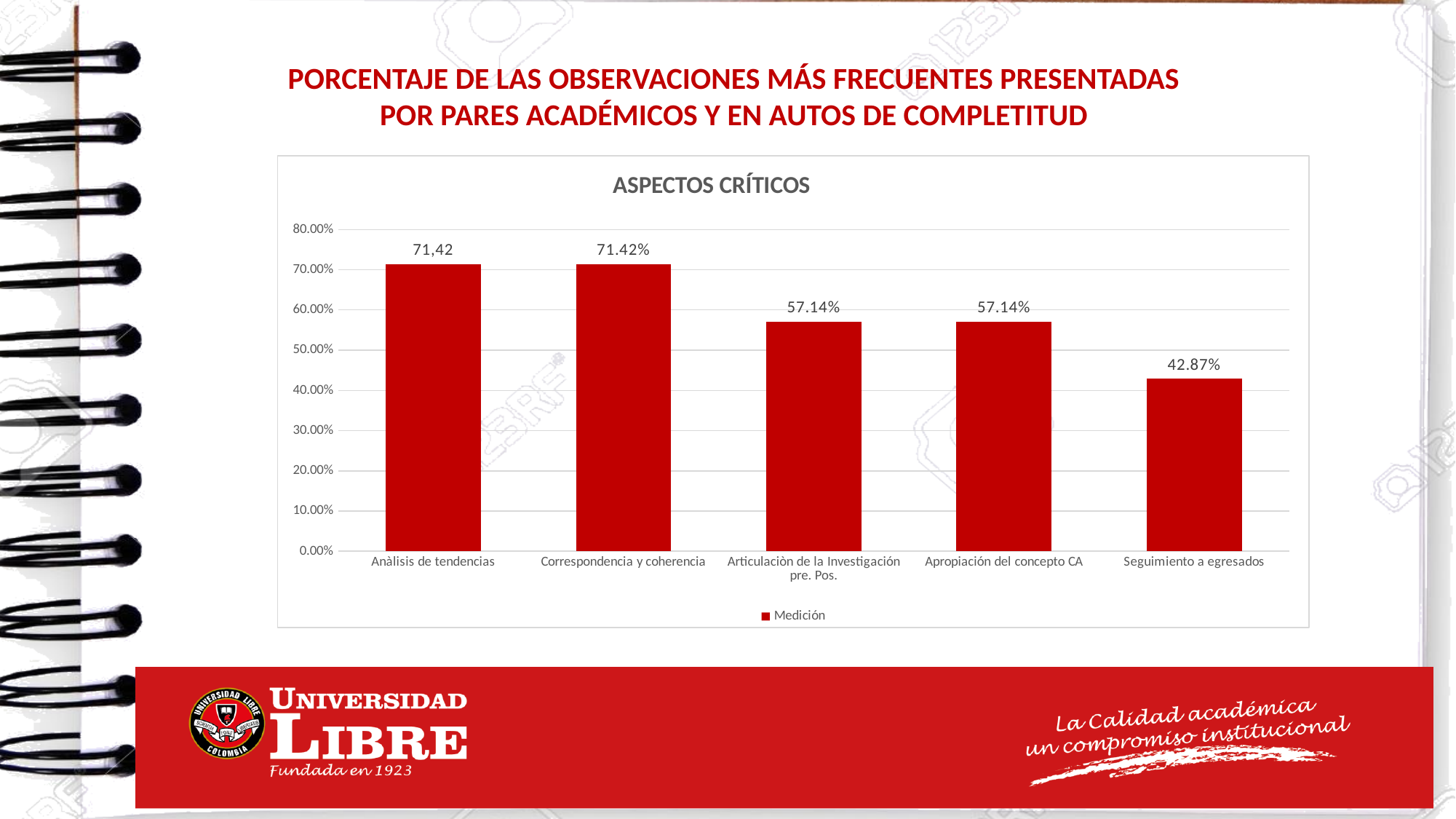
What data label is shown above the bar for Anàlisis de tendencias? 71,42 What is the difference between the values for Apropiación del concepto CA and Seguimiento a egresados? 14.27% Which is larger: the value for Correspondencia y coherencia or the value for Seguimiento a egresados? Correspondencia y coherencia What is the difference between the values for Correspondencia y coherencia and Articulaciòn de la Investigación pre. Pos.? 14.28% What type of chart is shown on the slide? Bar chart How many series does the legend of the ASPECTOS CRÍTICOS chart list? 1 What is the value for Correspondencia y coherencia in the ASPECTOS CRÍTICOS chart? 71.42% What is the value for Seguimiento a egresados in the ASPECTOS CRÍTICOS chart? 42.87% What is the value for Apropiación del concepto CA? 57.14% Is the value for Seguimiento a egresados greater or less than 50.00%? less Which category has the lowest value in the ASPECTOS CRÍTICOS chart? Seguimiento a egresados How many categories are shown on the x axis of the ASPECTOS CRÍTICOS chart? 5